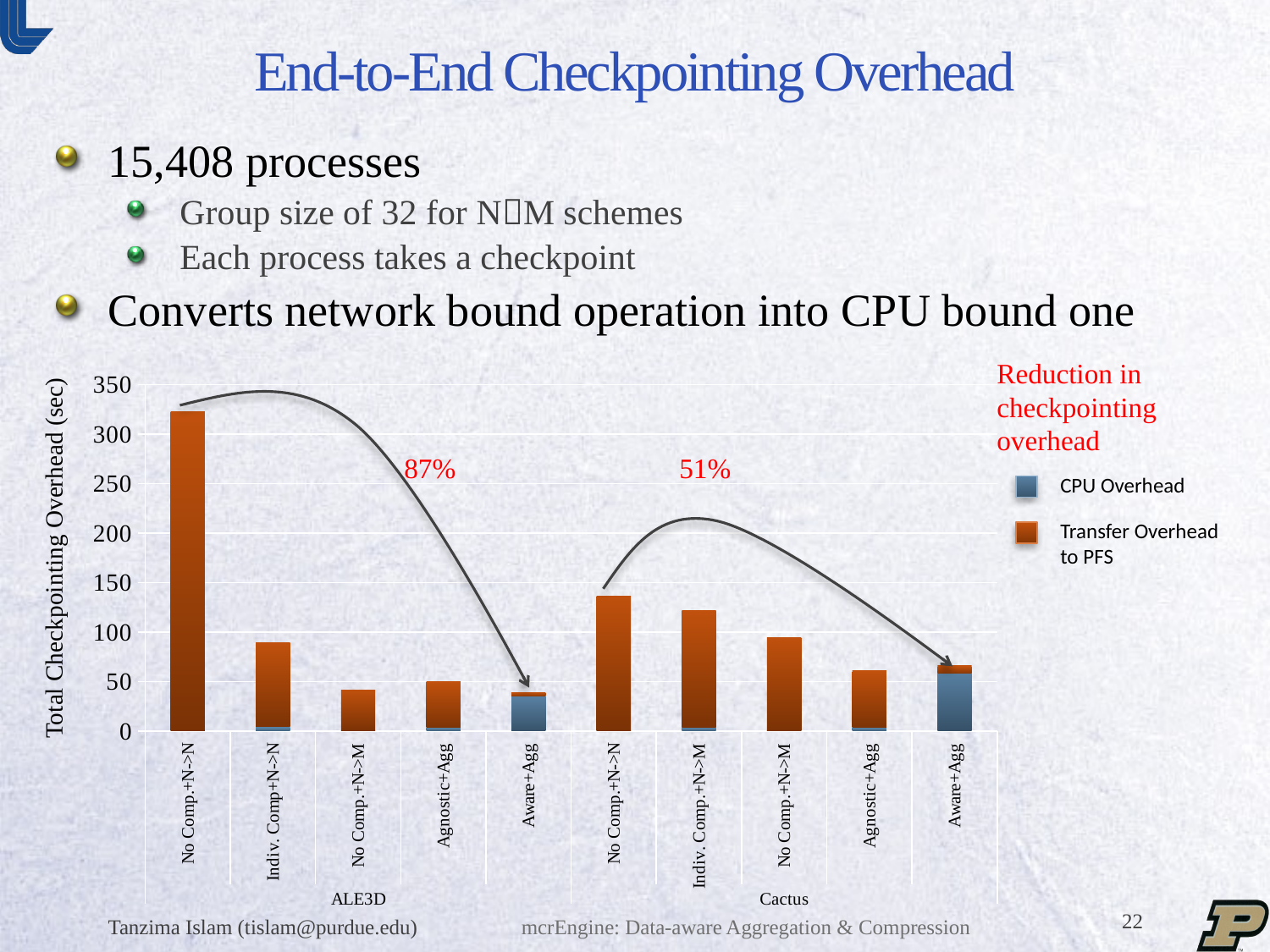
What kind of chart is shown on the slide? Stacked bar chart Which has the larger total checkpointing overhead under Cactus: Indiv. Comp.+N->M or No Comp.+N->M? Indiv. Comp.+N->M Is the total checkpointing overhead for No Comp.+N->N under Cactus greater or less than 150? less Which bar has the highest total checkpointing overhead? No Comp.+N->N (ALE3D) Which has the larger total checkpointing overhead: No Comp.+N->N under ALE3D or No Comp.+N->N under Cactus? No Comp.+N->N under ALE3D Is the total checkpointing overhead for Indiv. Comp.+N->M under Cactus greater or less than 100? greater How many bars are plotted in the chart? 10 Is the total checkpointing overhead for No Comp.+N->N under ALE3D greater or less than 300? greater How many series does the chart legend list? 2 What are the two series named in the chart legend? CPU Overhead; Transfer Overhead to PFS What reduction in checkpointing overhead is annotated for the ALE3D group? 87%